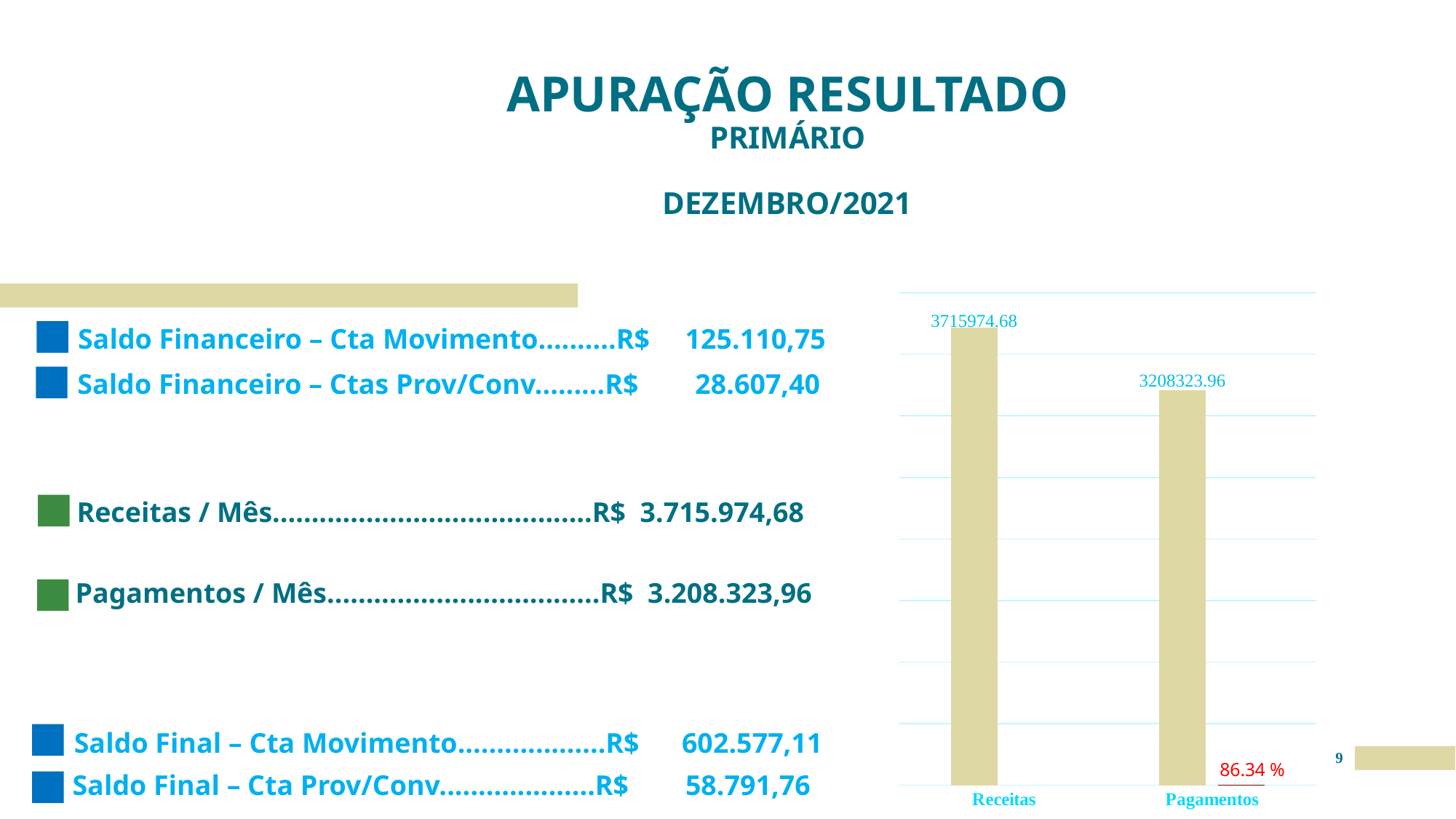
Which category has the lowest bar in the chart? Pagamentos What is the value of the Pagamentos bar in the chart? 3208323.96 How many bars are plotted in the chart? 2 Which is larger in the chart, Receitas or Pagamentos? Receitas Which category has the highest bar in the chart? Receitas What is the value of the Receitas bar in the chart? 3715974.68 What are the two category labels on the x axis of the chart? Receitas and Pagamentos What is the difference between the Receitas and Pagamentos values in the chart? 507650.72 What percentage is printed in red next to the Pagamentos bar? 86.34 % What type of chart is shown on the slide? Bar chart Do the values fall or rise from Receitas to Pagamentos in the chart? Fall